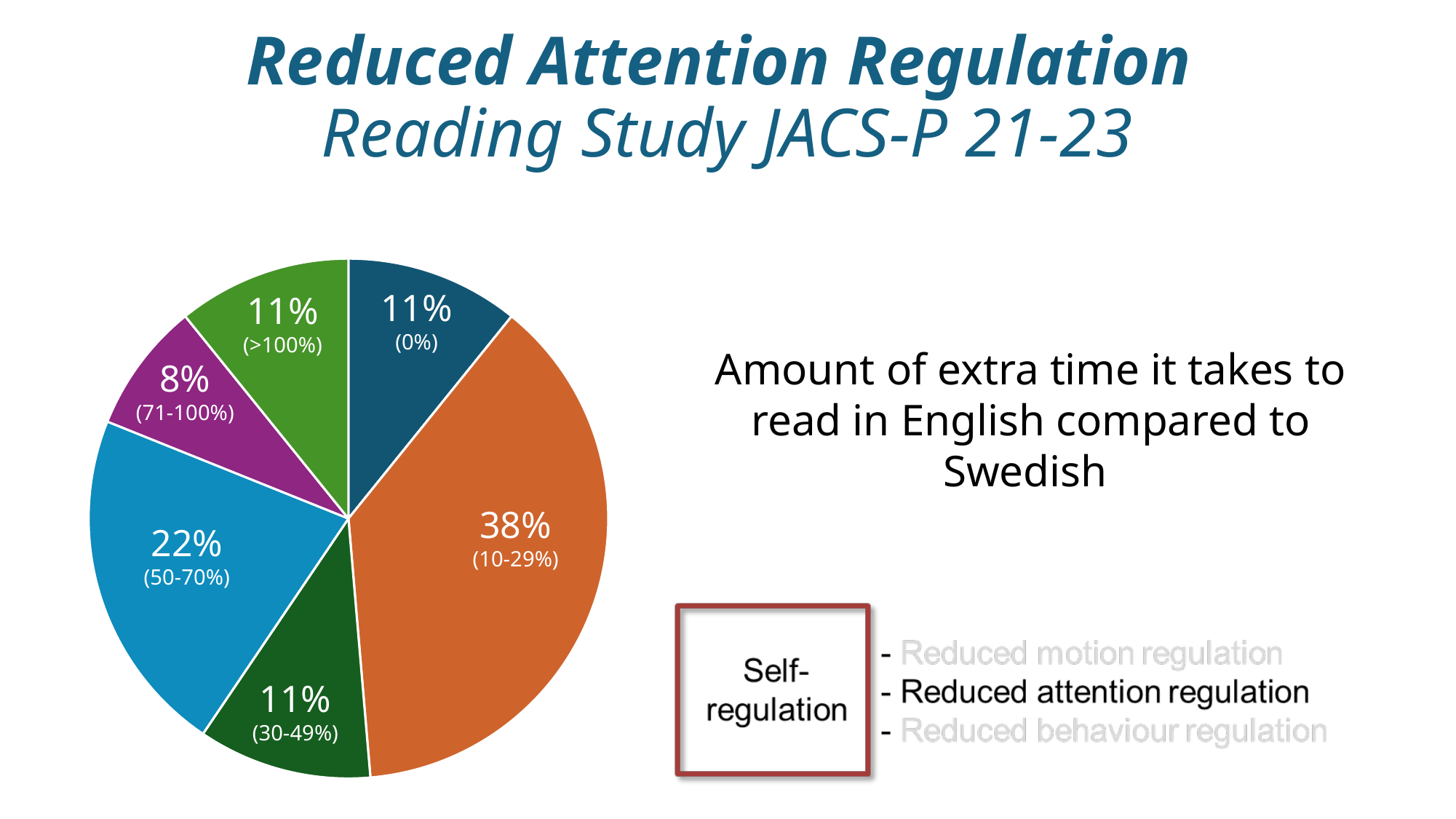
What is the difference in percentage points between the (10-29%) slice and the (50-70%) slice? 16 What share of the pie corresponds to the (10-29%) extra reading time category? 38% What colour is the slice for the (10-29%) category? Orange What share of the pie corresponds to the (0%) extra reading time category? 11% What share of the pie corresponds to the (50-70%) extra reading time category? 22% Which slice is larger, (50-70%) or (30-49%)? (50-70%) How many slices does the pie chart have? 6 What kind of chart is shown on the slide? Pie chart Which extra reading time category has the smallest slice of the pie? (71-100%) What is the combined share of the (71-100%) and (>100%) slices? 19% Which extra reading time category has the largest slice of the pie? (10-29%)